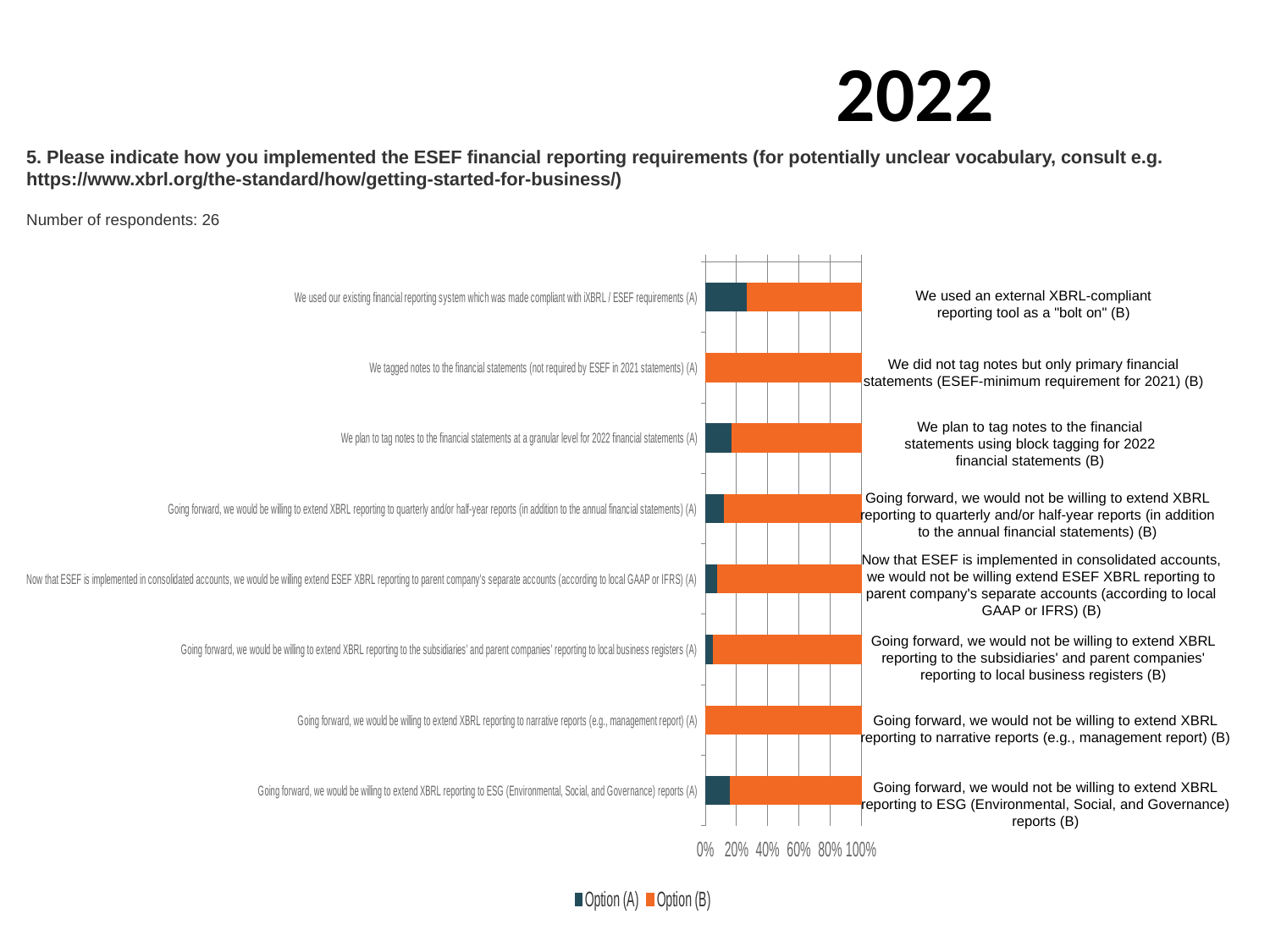
What is the total of the stacked bar for 'Going forward, we would be willing to extend XBRL reporting to ESG (Environmental, Social, and Governance) reports (A)'? 100% Is the Option (A) share for 'We used our existing financial reporting system which was made compliant with iXBRL / ESEF requirements (A)' greater or less than 40%? less Which statement has the largest Option (A) share? We used our existing financial reporting system which was made compliant with iXBRL / ESEF requirements (A) Is the Option (B) share for 'Going forward, we would be willing to extend XBRL reporting to narrative reports (e.g., management report) (A)' greater or less than 80%? greater How many statement pairs (bars) are plotted in the chart? 8 What kind of chart is shown on the slide? Stacked bar chart Which is larger: the Option (A) share for 'We plan to tag notes to the financial statements at a granular level for 2022 financial statements (A)' or for 'Going forward, we would be willing to extend XBRL reporting to the subsidiaries' and parent companies' reporting to local business registers (A)'? We plan to tag notes to the financial statements at a granular level for 2022 financial statements (A) Which colour represents Option (B) in the chart? Orange How many series does the legend list? 2 Is the Option (B) share for 'We tagged notes to the financial statements (not required by ESEF in 2021 statements) (A)' greater or less than 80%? greater What are the two series named in the legend? Option (A) and Option (B)